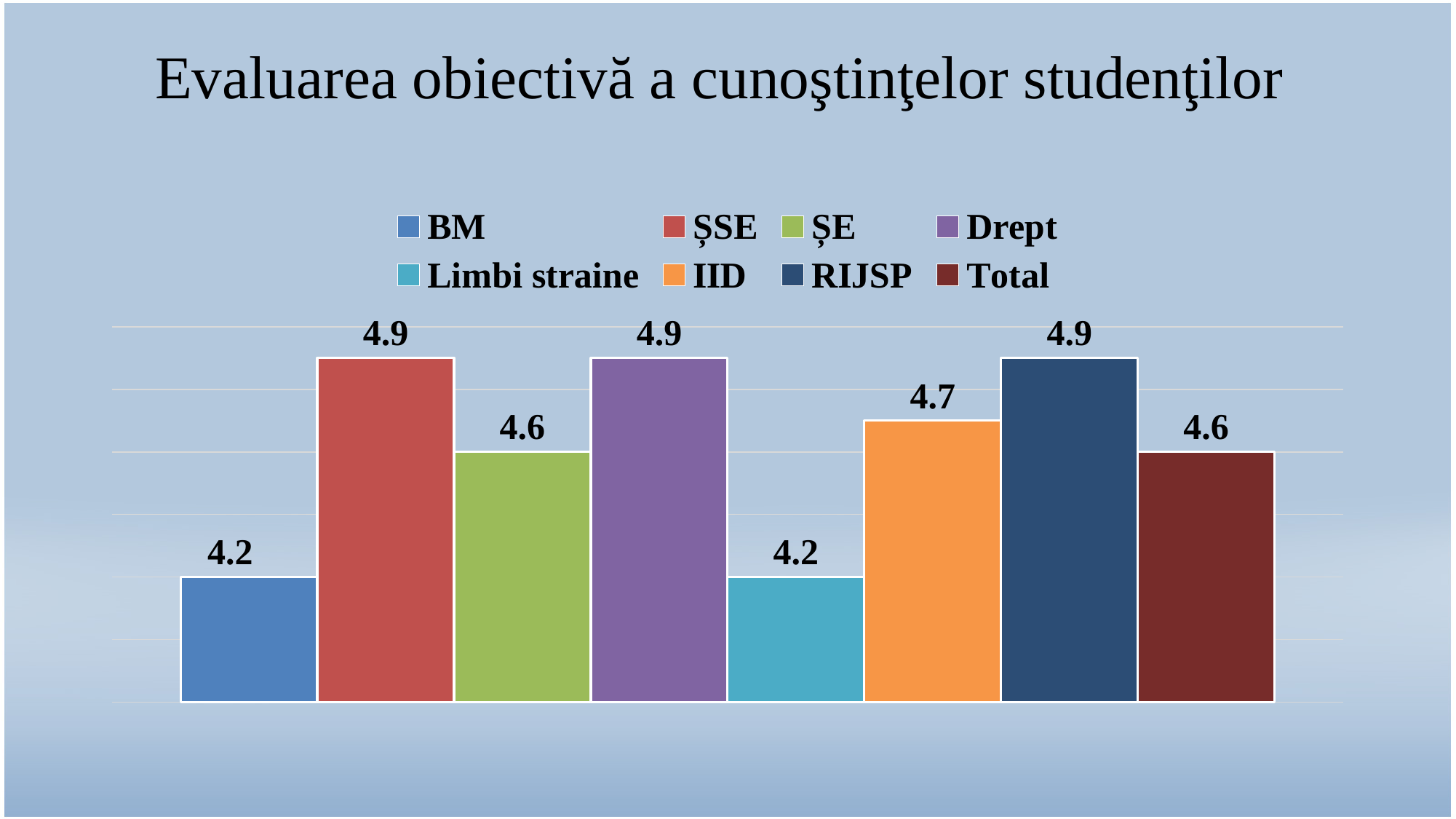
What kind of chart is shown on the slide? Bar chart Which is larger, the value for IID or the value for ȘE? IID How many bars are plotted in the chart? 8 What is the highest value shown in the chart? 4.9 How many entries does the legend list? 8 What is the value for BM? 4.2 What is the difference between the values for ȘSE and BM? 0.7 What is the value for Total? 4.6 What is the value for IID? 4.7 What is the lowest value shown in the chart? 4.2 What is the value for ȘE? 4.6 What is the value for Limbi straine? 4.2